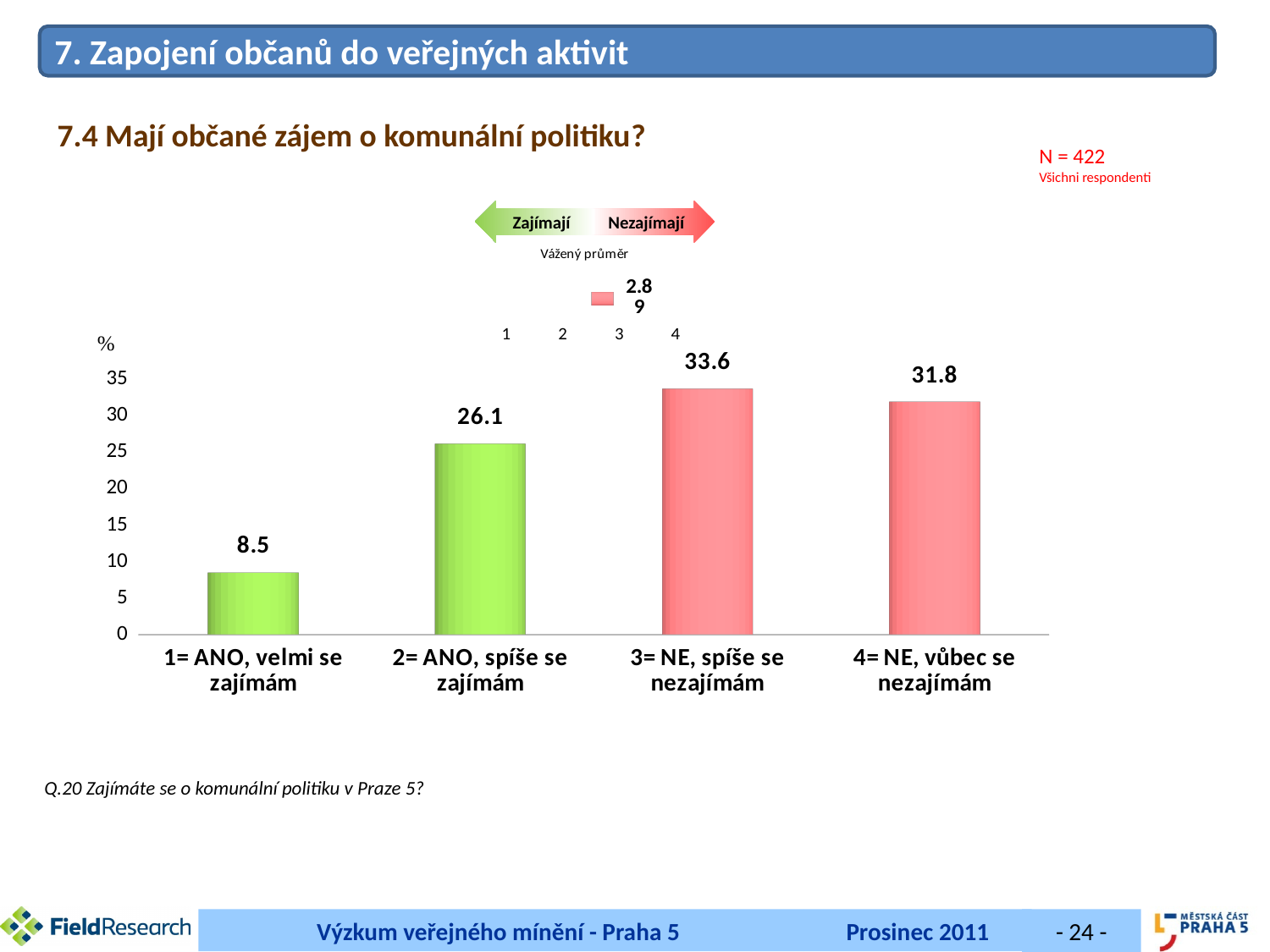
In the bar chart, what is the difference between the values for "2= ANO, spíše se zajímám" and "1= ANO, velmi se zajímám"? 17.6 In the bar chart, which category has the highest value? 3= NE, spíše se nezajímám What kind of chart is used to show the responses to Q.20? Bar chart In the bar chart, which category has the lowest value? 1= ANO, velmi se zajímám In the bar chart, which is larger: the value for "2= ANO, spíše se zajímám" or the value for "4= NE, vůbec se nezajímám"? 4= NE, vůbec se nezajímám In the bar chart, what is the value for "3= NE, spíše se nezajímám"? 33.6 In the bar chart, what is the difference between the values for "3= NE, spíše se nezajímám" and "4= NE, vůbec se nezajímám"? 1.8 What is the sample size (N) stated on the slide? N = 422 In the bar chart, what is the value for "2= ANO, spíše se zajímám"? 26.1 How many categories are shown in the bar chart? 4 In the bar chart, what is the value for "1= ANO, velmi se zajímám"? 8.5 In the bar chart, what is the value for "4= NE, vůbec se nezajímám"? 31.8